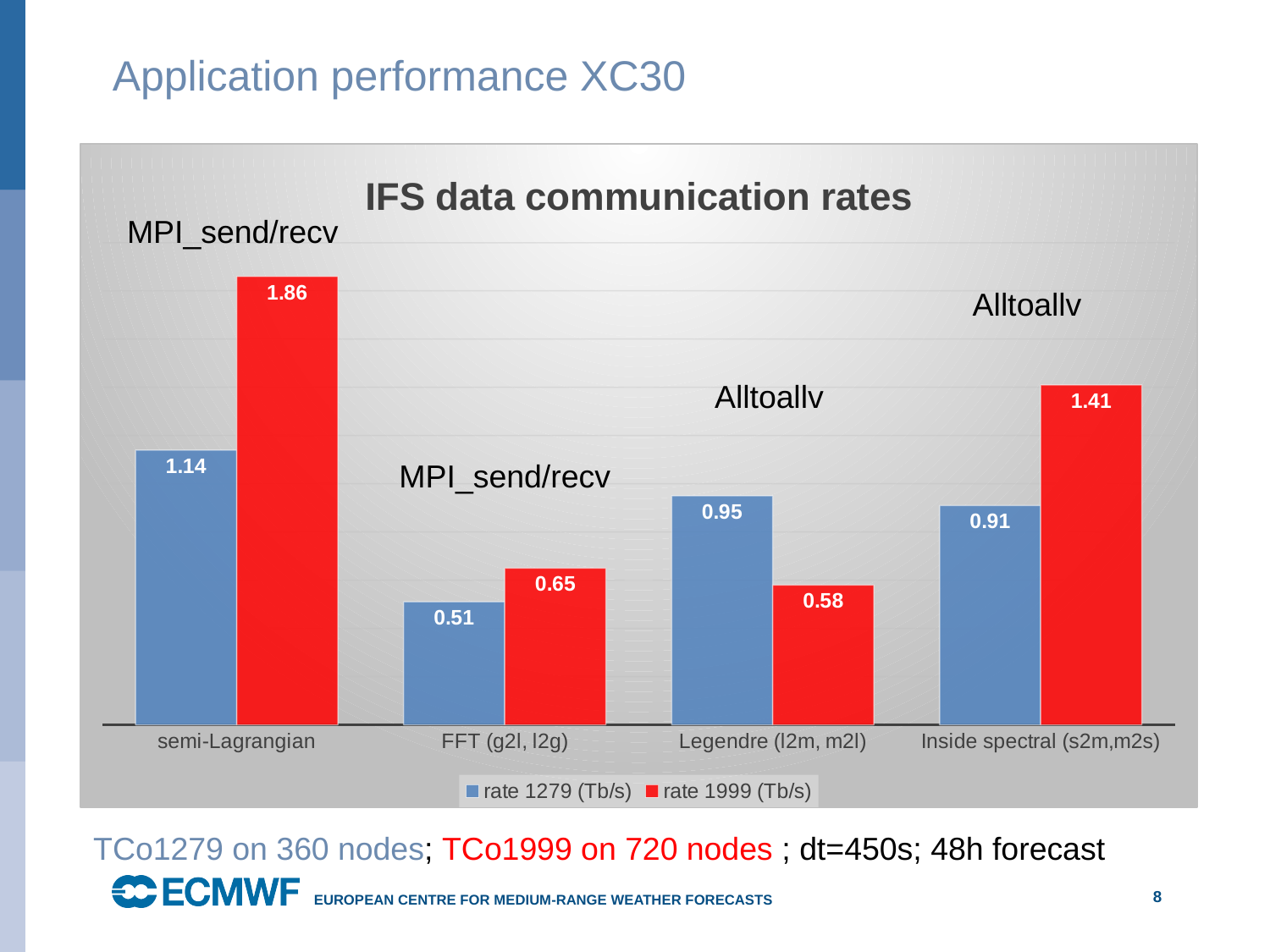
Which colour represents the rate 1999 (Tb/s) series? red How many series does the legend list? 2 For Legendre (l2m, m2l), which series has the larger value: rate 1279 (Tb/s) or rate 1999 (Tb/s)? rate 1279 (Tb/s) Which category has the highest rate 1999 (Tb/s) value? semi-Lagrangian How many categories are shown on the x axis? 4 What kind of chart is shown on the slide? bar chart What is the title of the chart? IFS data communication rates What is the rate 1999 (Tb/s) value for Inside spectral (s2m,m2s)? 1.41 What is the difference between the rate 1999 (Tb/s) and rate 1279 (Tb/s) values for semi-Lagrangian? 0.72 What is the rate 1999 (Tb/s) value for FFT (g2l, l2g)? 0.65 What is the rate 1279 (Tb/s) value for semi-Lagrangian? 1.14 Which category has the lowest rate 1279 (Tb/s) value? FFT (g2l, l2g)